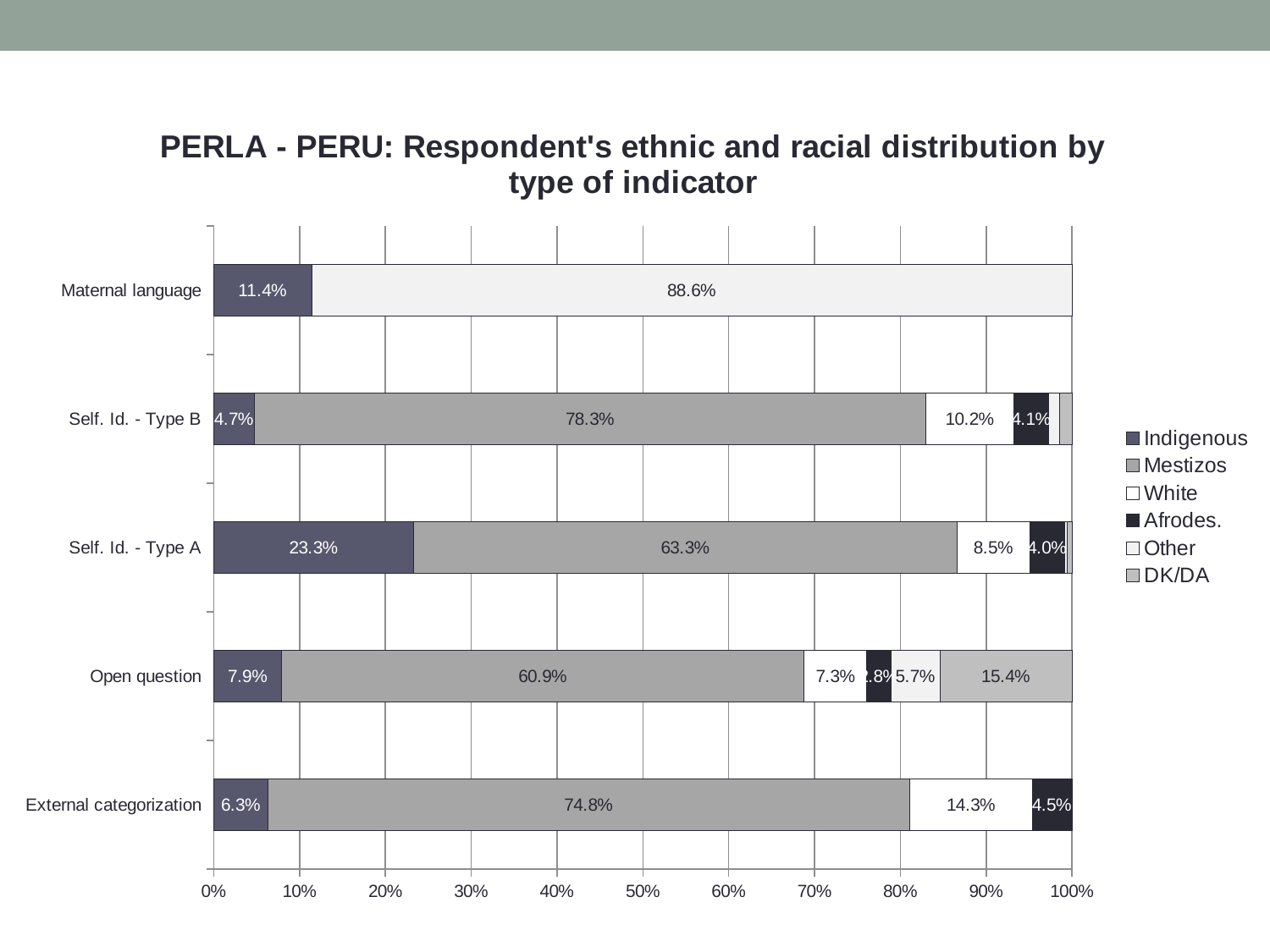
What is the Indigenous share for Maternal language? 11.4% What is the DK/DA share for Open question? 15.4% What kind of chart is shown on the slide? Stacked bar chart Which indicator has the highest Indigenous share? Self. Id. - Type A How many series does the legend list? 6 What is the title of the chart? PERLA - PERU: Respondent's ethnic and racial distribution by type of indicator Which has a larger White share: External categorization or Self. Id. - Type B? External categorization How much larger is the Mestizos share for Self. Id. - Type B than for Self. Id. - Type A? 15.0 percentage points What is the Mestizos share for External categorization? 74.8% Which indicator has the lowest Indigenous share? Self. Id. - Type B What is the Indigenous share for Self. Id. - Type A? 23.3% How many indicator categories are shown on the vertical axis? 5